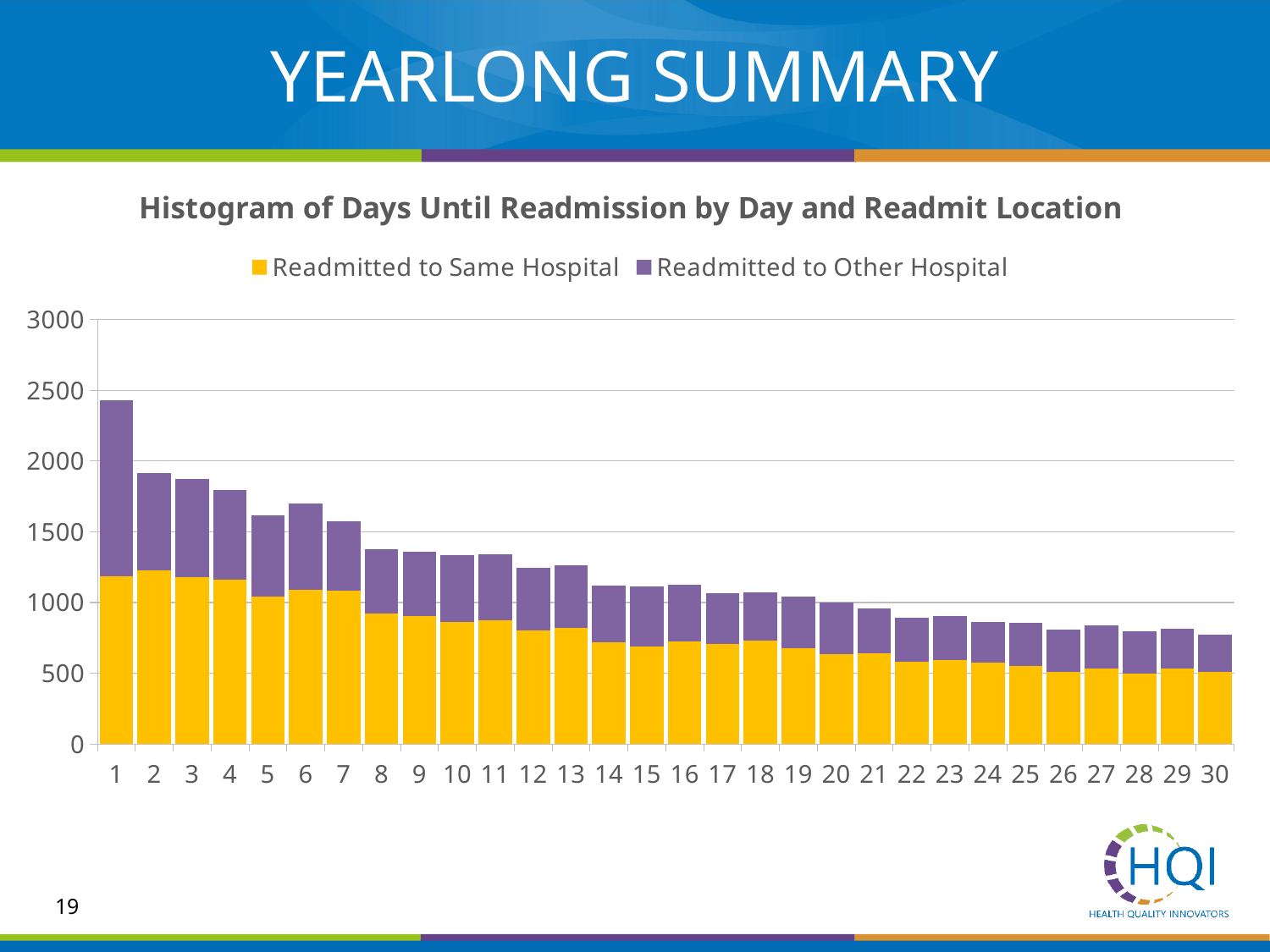
How many days (categories) are shown along the x axis? 30 Is the 'Readmitted to Same Hospital' value for day 1 greater or less than 1000? greater Do the total values generally rise or fall as the day number increases? Fall Is the total value for day 8 greater or less than 1500? less What kind of chart is shown on the slide? Stacked bar chart Which day has the highest total number of readmissions? 1 How many series does the legend list? 2 Is the total value for day 30 greater or less than 1000? less Which has a larger total, day 1 or day 10? Day 1 Which series is shown in purple? Readmitted to Other Hospital